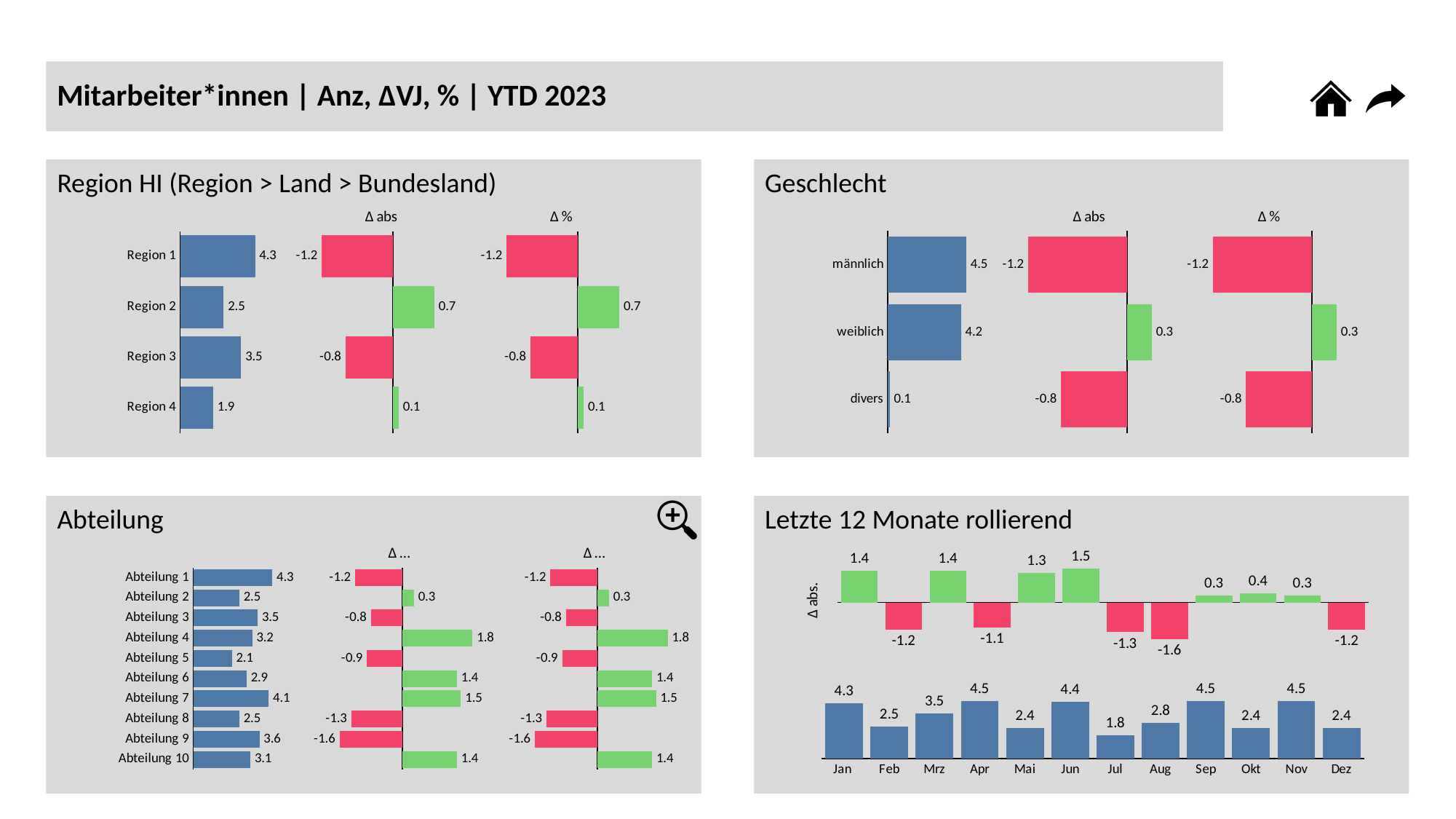
In the 'Abteilung' chart, how many Abteilungen are shown? 10 In the 'Geschlecht' chart, what is the value for weiblich? 4.2 In the 'Letzte 12 Monate rollierend' chart, which month has the lowest value in the bottom bar chart? Jul In the 'Abteilung' chart, what is the Δ value for Abteilung 9? -1.6 In the 'Region HI' chart, which region has the lowest value? Region 4 In the 'Geschlecht' chart, what is the difference between the values for männlich and weiblich? 0.3 In the 'Region HI' chart, what is the value for Region 3? 3.5 In the 'Abteilung' chart, which Abteilung has the highest value? Abteilung 1 What kind of chart is used in the 'Letzte 12 Monate rollierend' panel? Bar chart In the 'Region HI' chart, what is the Δ abs value for Region 2? 0.7 In the 'Letzte 12 Monate rollierend' chart, what is the Δ abs value for Aug? -1.6 In the 'Geschlecht' chart, what is the Δ % value for divers? -0.8